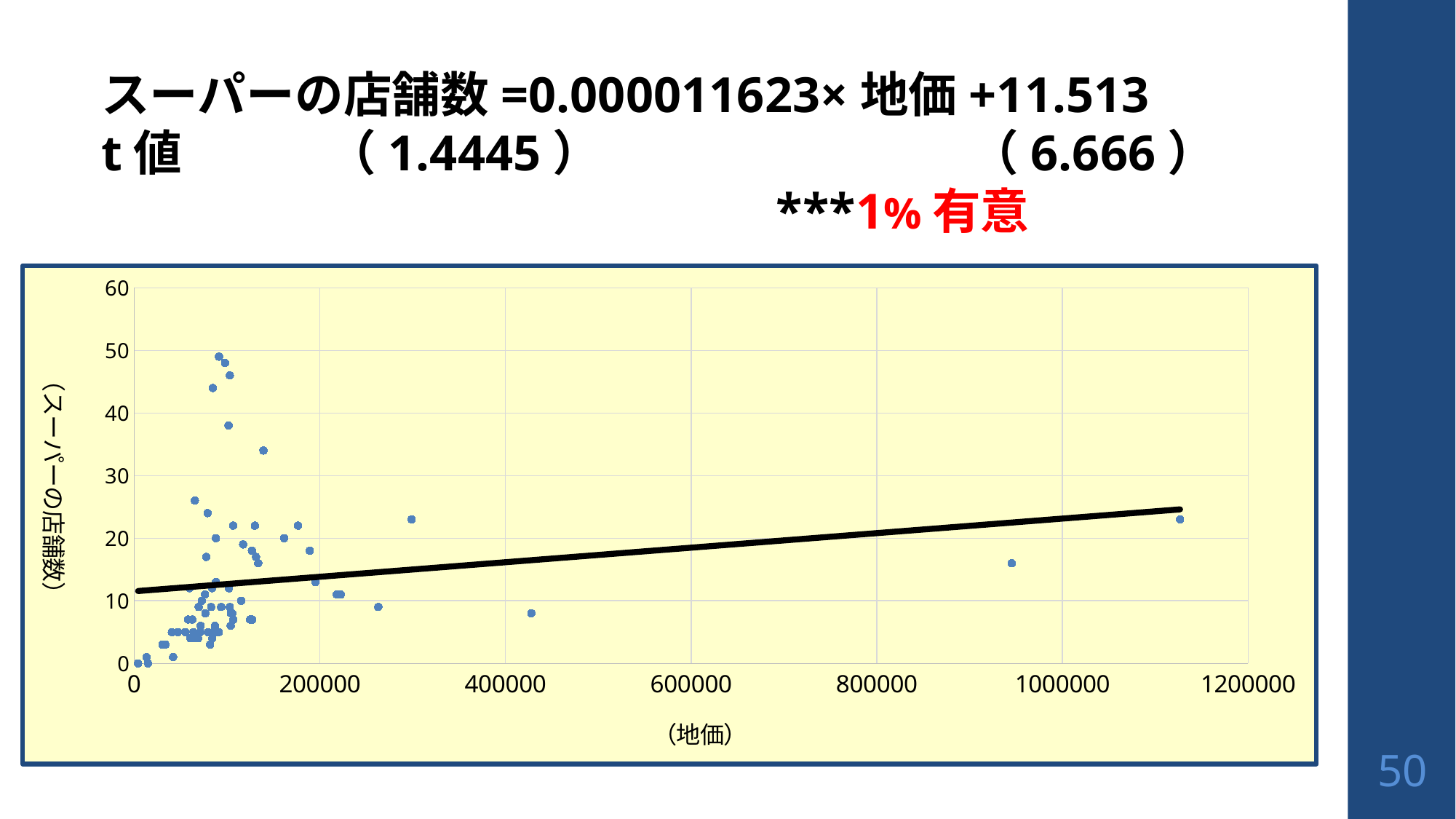
Is the value for the point with the largest 地価 (near 1,130,000) greater or less than 30? less What is the label of the x axis? （地価） Is the value for the point near 地価 430,000 greater or less than 10? less Is the value for the point near 地価 950,000 greater or less than 20? less What is the maximum value shown on the y axis? 60 Does the fitted trend line rise or fall as 地価 increases along the x axis? rises Which has more stores: the point near 地価 1,130,000 or the point near 地価 430,000? the point near 1,130,000 What is the label of the y axis? （スーパーの店舗数） What kind of chart is shown on the slide? scatter chart